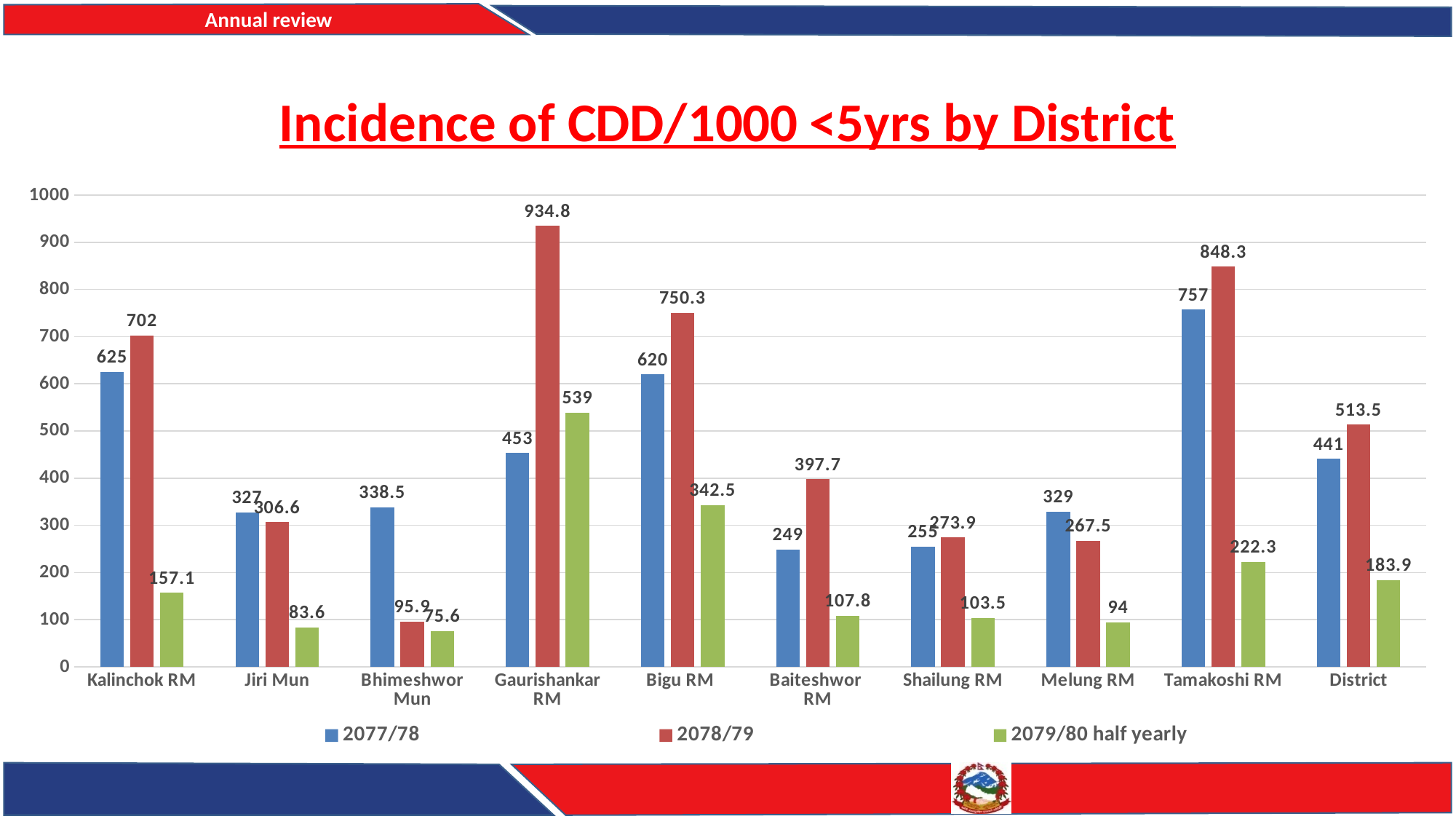
What is the difference between the 2078/79 and 2077/78 values for Tamakoshi RM? 91.3 What is the 2078/79 value for Gaurishankar RM? 934.8 Which category has the lowest 2079/80 half yearly value? Bhimeshwor Mun What is the 2079/80 half yearly value for Kalinchok RM? 157.1 For Jiri Mun, which series has the larger value, 2077/78 or 2078/79? 2077/78 Which category has the highest 2077/78 value? Tamakoshi RM Is the 2077/78 value for Bigu RM greater or less than 500? greater What kind of chart is shown on the slide? bar chart How many series does the legend list? 3 Which category has the highest 2078/79 value? Gaurishankar RM What is the 2077/78 value for District? 441 How many categories are shown on the x axis? 10